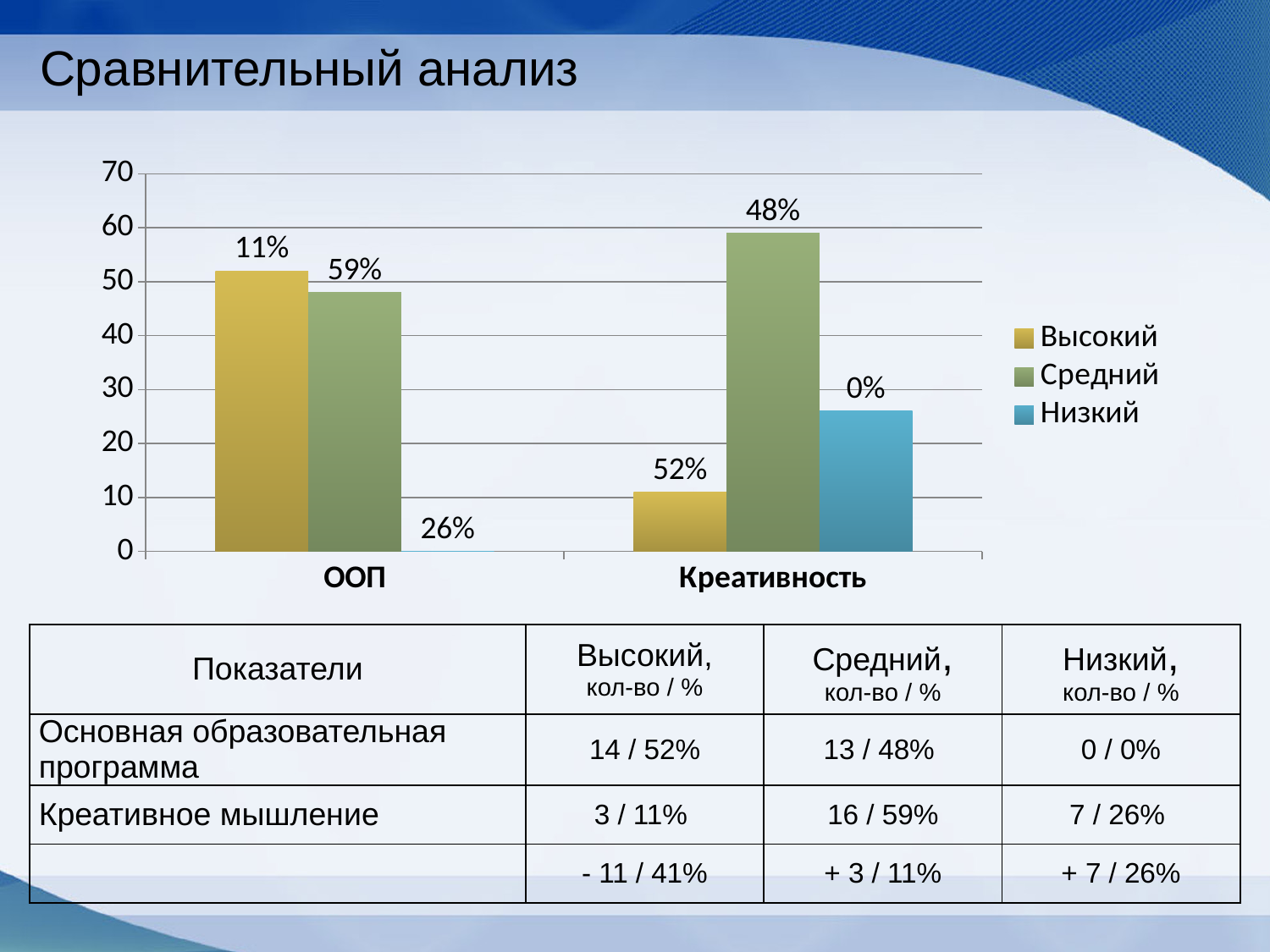
Is the Средний bar for Креативность greater or less than 50? greater Is the Низкий bar for Креативность greater or less than 30? less What is the title of the slide containing the chart? Сравнительный анализ How many categories are shown on the x axis of the chart? 2 Which series has the tallest bar in the Креативность category? Средний Is the Средний bar taller for ООП or for Креативность? Креативность Which series has the shortest bar in the Креативность category? Высокий Which series is shown in blue in the chart legend? Низкий What kind of chart is shown on the slide? bar chart Which series has the tallest bar in the ООП category? Высокий Is the Высокий bar for Креативность greater or less than 20? less How many series does the chart legend list? 3